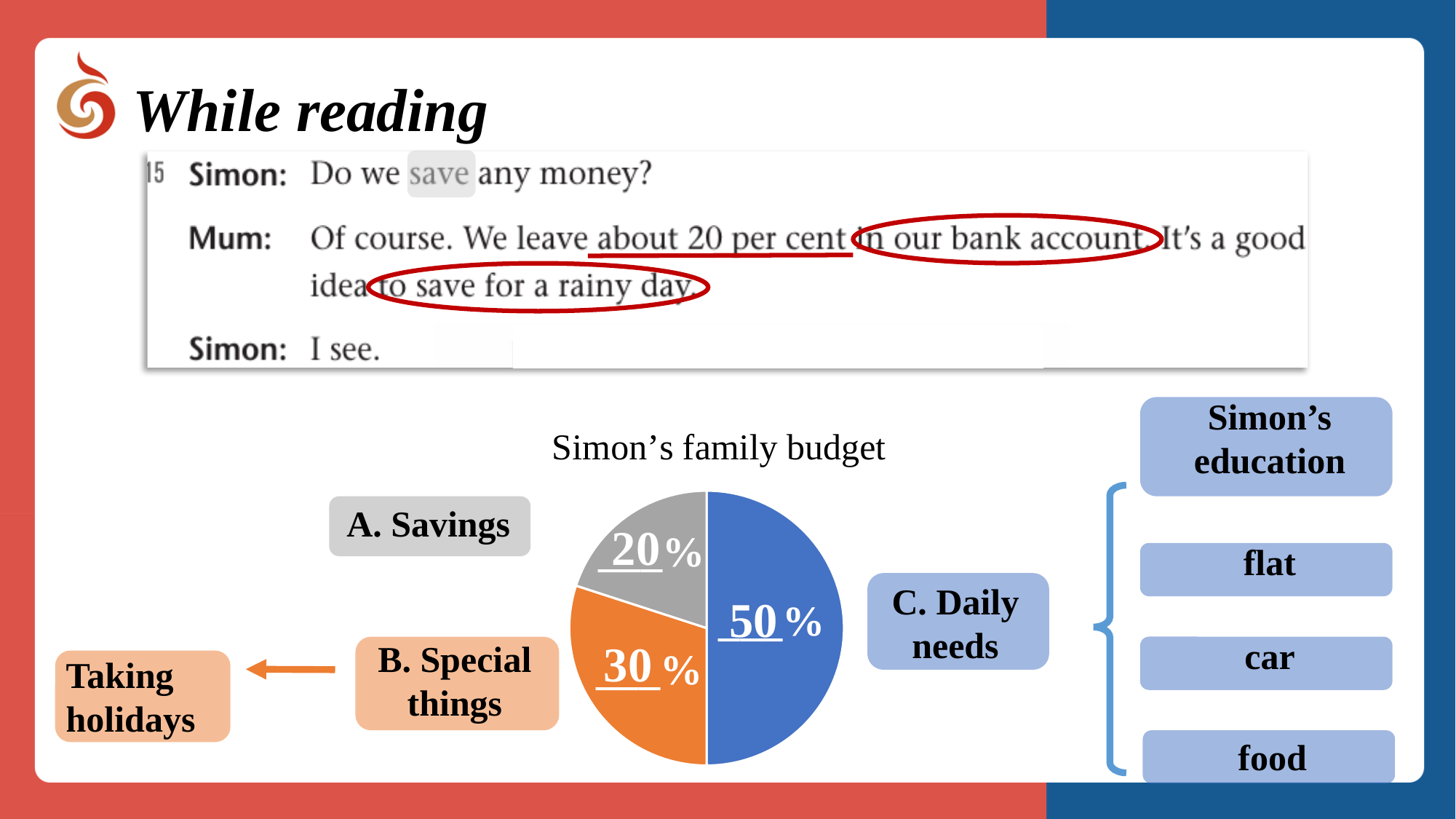
Which category takes the smallest share of Simon's family budget? Savings What share of Simon's family budget goes to Savings? 20% What is the difference between the Special things share and the Savings share? 10% What share of Simon's family budget goes to Daily needs? 50% What is the title of the pie chart? Simon's family budget What is the difference between the Daily needs share and the Savings share? 30% What kind of chart is shown on the slide? pie chart Which is larger, the share for Special things or the share for Savings? Special things What share of Simon's family budget goes to Special things? 30% Which category takes the largest share of Simon's family budget? Daily needs What colour is the Daily needs slice of the pie chart? blue How many slices does the pie chart have? 3